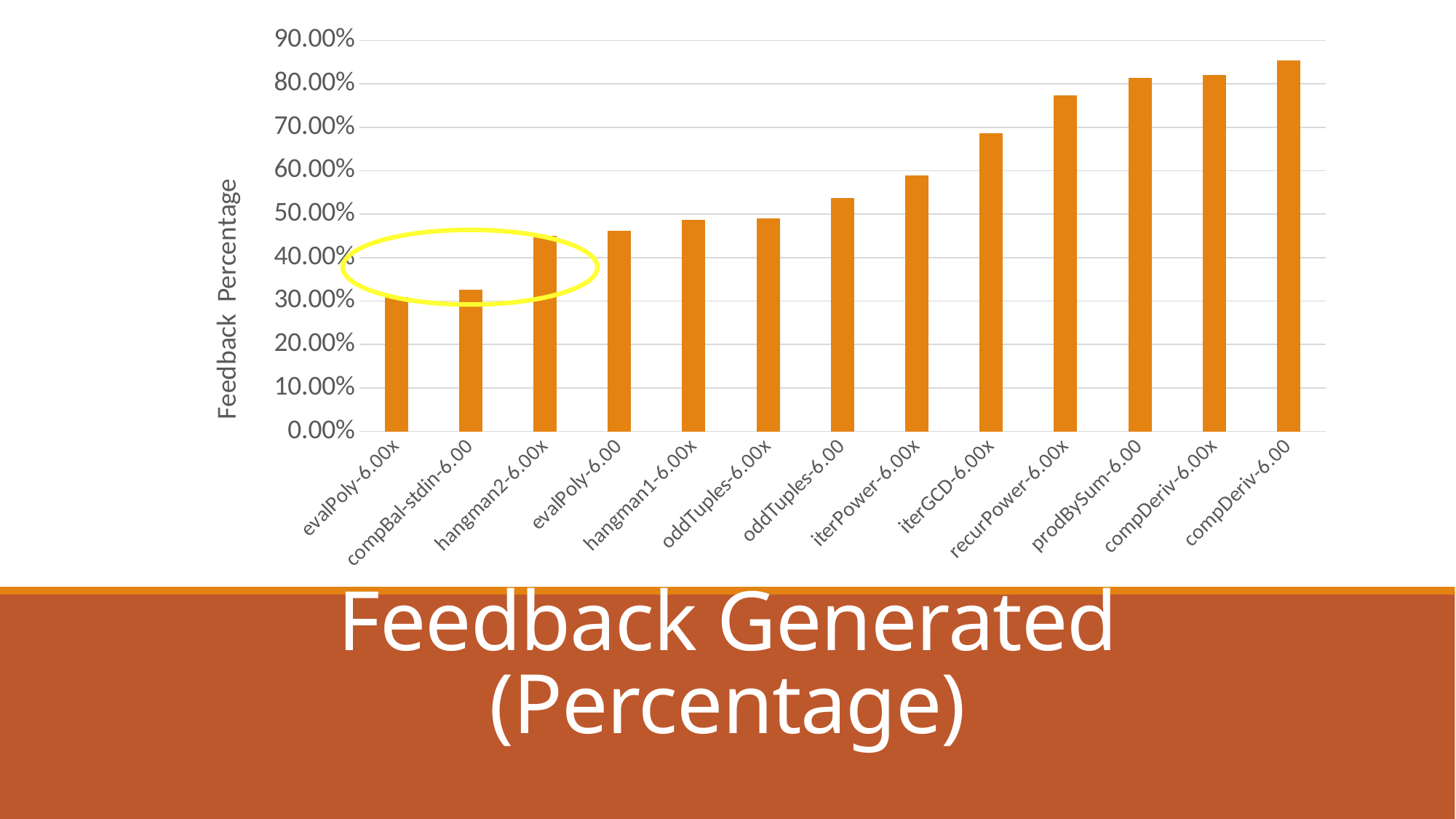
What is the label of the vertical axis? Feedback Percentage Is the value for iterGCD-6.00x greater or less than 60.00%? greater Is the value for compDeriv-6.00 greater or less than 80.00%? greater Is the value for recurPower-6.00x greater or less than 70.00%? greater What kind of chart is shown on the slide? bar chart Which category has the highest feedback percentage? compDeriv-6.00 Do the bar values rise or fall from left to right along the x axis? rise How many categories (bars) are plotted in the chart? 13 Which has a larger feedback percentage, iterGCD-6.00x or oddTuples-6.00? iterGCD-6.00x What is the title shown below the chart? Feedback Generated (Percentage)